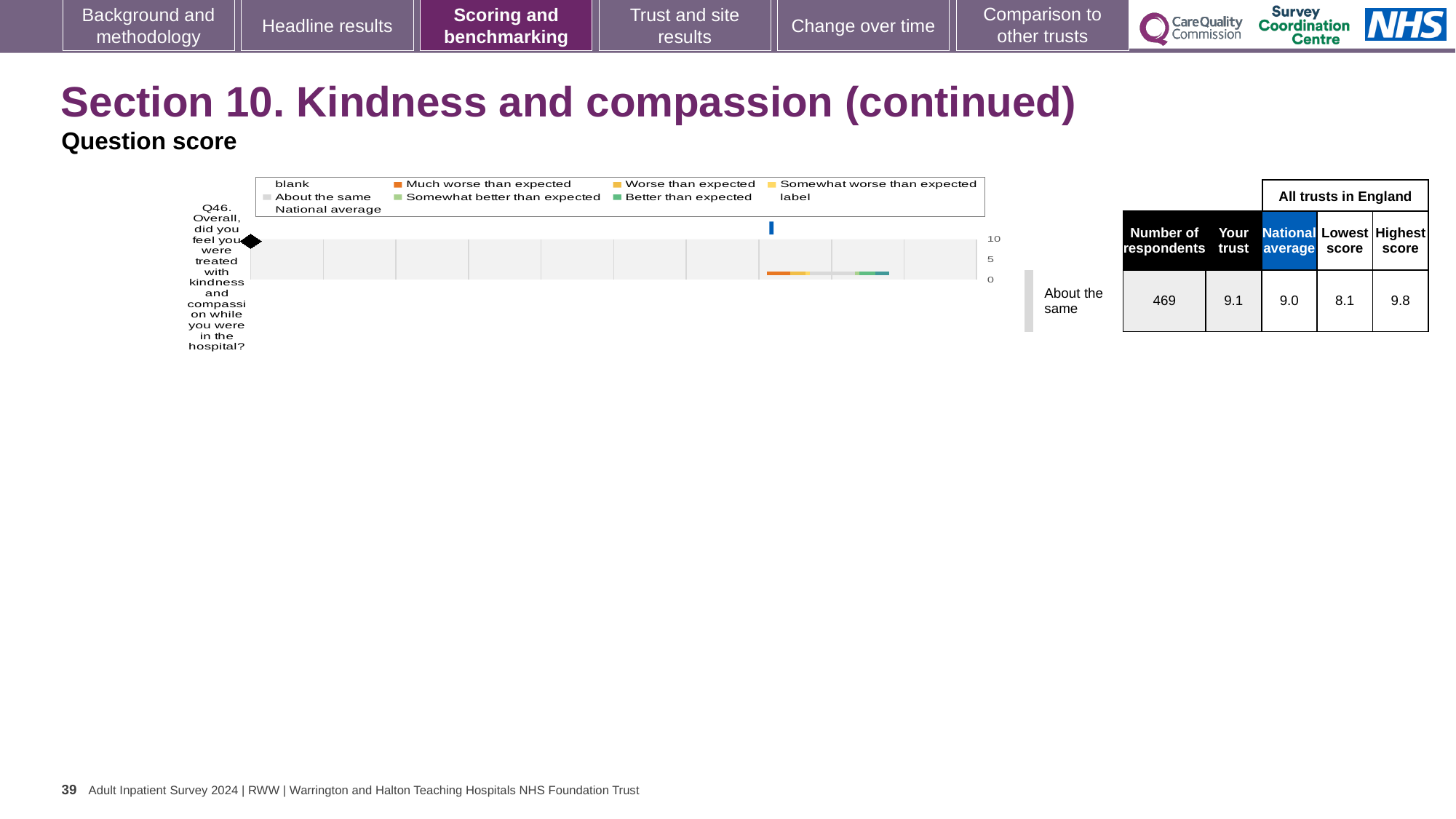
In the table beside the chart, what is the Highest score among all trusts in England for Q46? 9.8 In the table beside the chart, what is the 'Your trust' score for Q46? 9.1 In the table beside the chart, what is the National average score for Q46? 9.0 How many questions (categories) are plotted in the chart? 1 In the table beside the chart, what is the difference between the Highest score and the Lowest score for Q46? 1.7 What kind of chart is shown for Q46 on this slide? bar chart What benchmark category is shown for Q46 next to the chart? About the same How many entries does the chart legend list? 9 Which legend entry is shown in orange? Much worse than expected What is the highest tick value shown on the chart's axis? 10 In the table beside the chart, how many respondents answered Q46? 469 In the table beside the chart, which is larger for Q46: the 'Your trust' score or the National average? Your trust